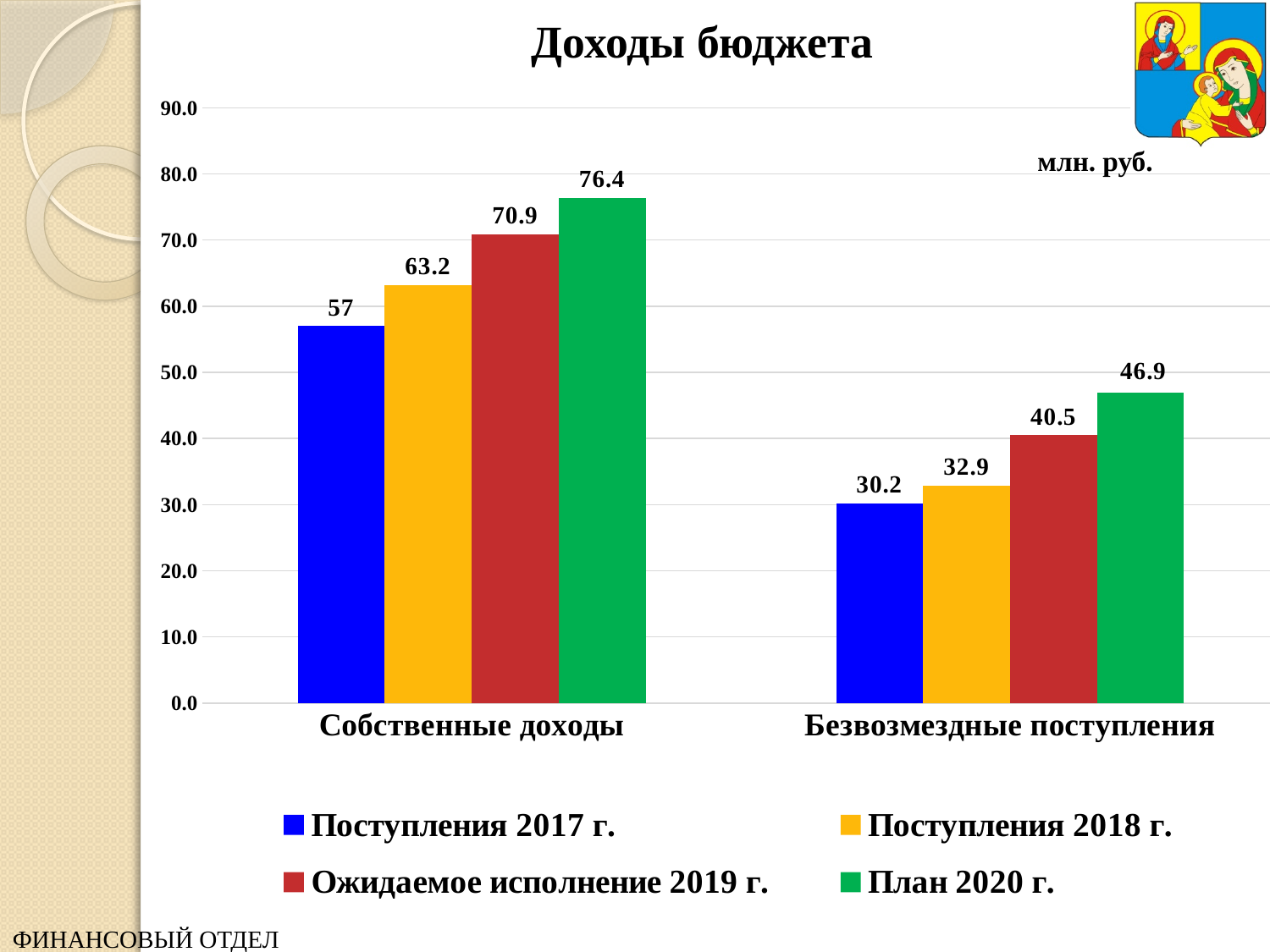
What is the value for Поступления 2017 г. in the Собственные доходы category? 57 Which is larger: Поступления 2018 г. for Собственные доходы or План 2020 г. for Безвозмездные поступления? Поступления 2018 г. for Собственные доходы What is the value for Ожидаемое исполнение 2019 г. in the Собственные доходы category? 70.9 What is the title of the chart? Доходы бюджета How many categories are shown on the x axis? 2 Which series has the highest value in the Безвозмездные поступления category? План 2020 г. What is the value for План 2020 г. in the Безвозмездные поступления category? 46.9 How many series does the legend list? 4 Which series has the lowest value in the Собственные доходы category? Поступления 2017 г. What kind of chart is shown on the slide? Bar chart Do the values for Безвозмездные поступления rise or fall from Поступления 2017 г. to План 2020 г.? Rise What is the difference between План 2020 г. and Поступления 2017 г. in the Собственные доходы category? 19.4